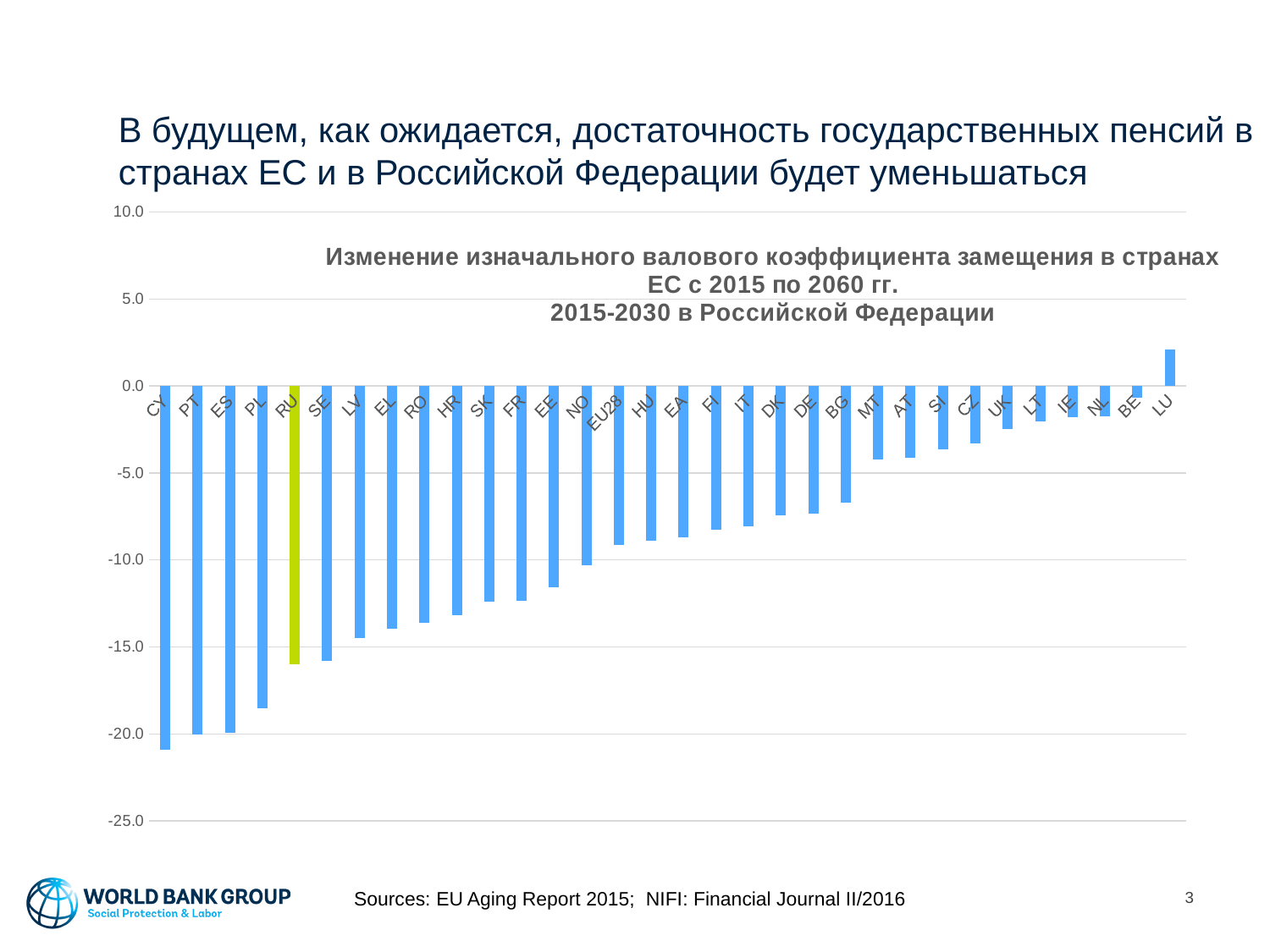
Is the value for LU greater or less than 0.0? greater Which has the larger value, HR or UK? UK Is the value for PL greater or less than -20.0? greater What kind of chart is shown on the slide? bar chart Which category has the lowest value in the chart? CY Do the values rise or fall moving from left to right along the x axis? rise Is the value for MT greater or less than -5.0? greater Which category has the highest value in the chart? LU How many categories (countries/regions) are plotted on the x axis? 32 Which category's bar is highlighted in a different colour (yellow-green) from the others? RU